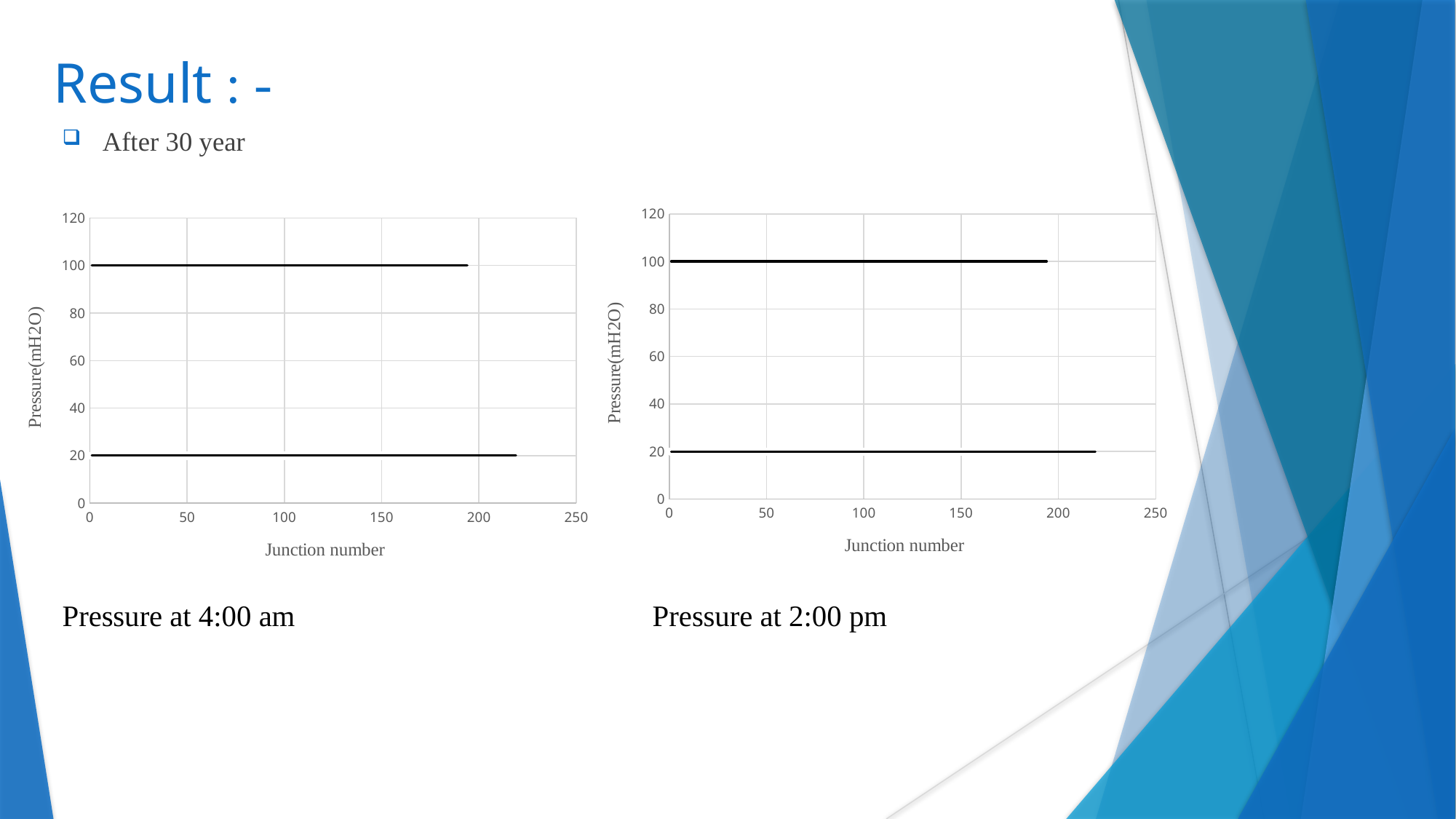
In the 'Pressure at 4:00 am' chart, at what pressure value does the upper line sit? 100 In the 'Pressure at 4:00 am' chart, how many horizontal lines are plotted? 2 In the 'Pressure at 2:00 pm' chart, does the pressure of the upper line rise, fall, or stay flat as the junction number increases? stay flat In the 'Pressure at 4:00 am' chart, what is the label of the y axis? Pressure(mH2O) In the 'Pressure at 2:00 pm' chart, how many horizontal lines are plotted? 2 In the 'Pressure at 2:00 pm' chart, what is the label of the x axis? Junction number In the 'Pressure at 4:00 am' chart, at what pressure value does the lower line sit? 20 In the 'Pressure at 2:00 pm' chart, at what pressure value does the upper line sit? 100 In the 'Pressure at 4:00 am' chart, is the pressure of the lower line greater or less than 40? less In the 'Pressure at 4:00 am' chart, what is the difference in pressure between the upper and lower lines? 80 In the 'Pressure at 2:00 pm' chart, what is the highest value shown on the y axis? 120 In the 'Pressure at 2:00 pm' chart, at what pressure value does the lower line sit? 20